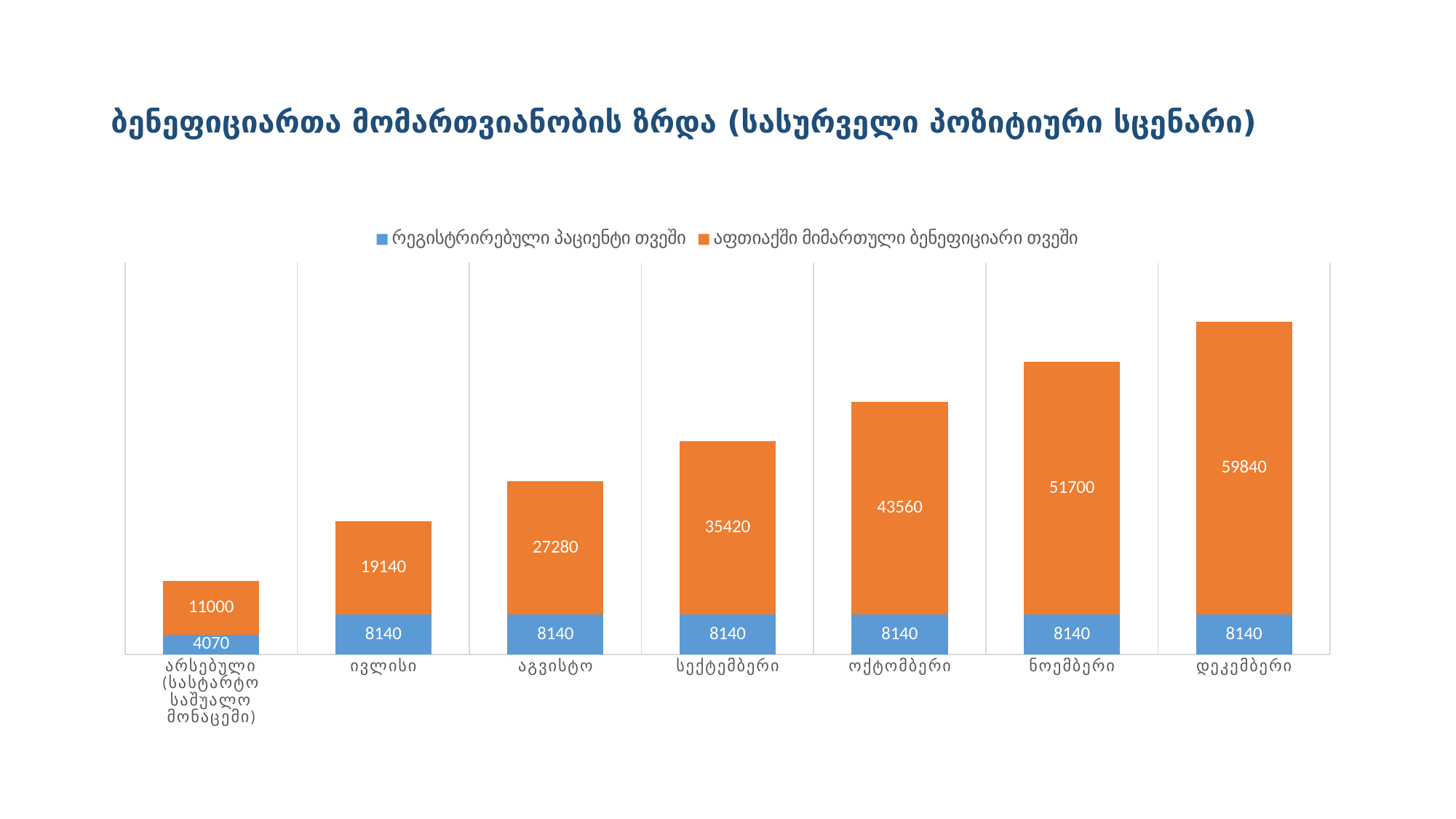
What is the value of the orange series (აფთიაქში მიმართული ბენეფიციარი თვეში) for დეკემბერი? 59840 How many categories are shown on the x axis? 7 What is the difference between the orange series values for ნოემბერი and ოქტომბერი? 8140 What is the value of the blue series (რეგისტრირებული პაციენტი თვეში) for არსებული (სასტარტო საშუალო მონაცემი)? 4070 How many series does the legend list? 2 What is the total of the stacked bar for დეკემბერი? 67980 Which category has the lowest value for the blue series (რეგისტრირებული პაციენტი თვეში)? არსებული (სასტარტო საშუალო მონაცემი) Do the orange series values rise or fall from left to right along the x axis? Rise Which is larger: the orange series value for აგვისტო or for ივლისი? აგვისტო What kind of chart is shown on the slide? Stacked bar chart What is the value of the orange series for სექტემბერი? 35420 Which category has the highest value for the orange series (აფთიაქში მიმართული ბენეფიციარი თვეში)? დეკემბერი